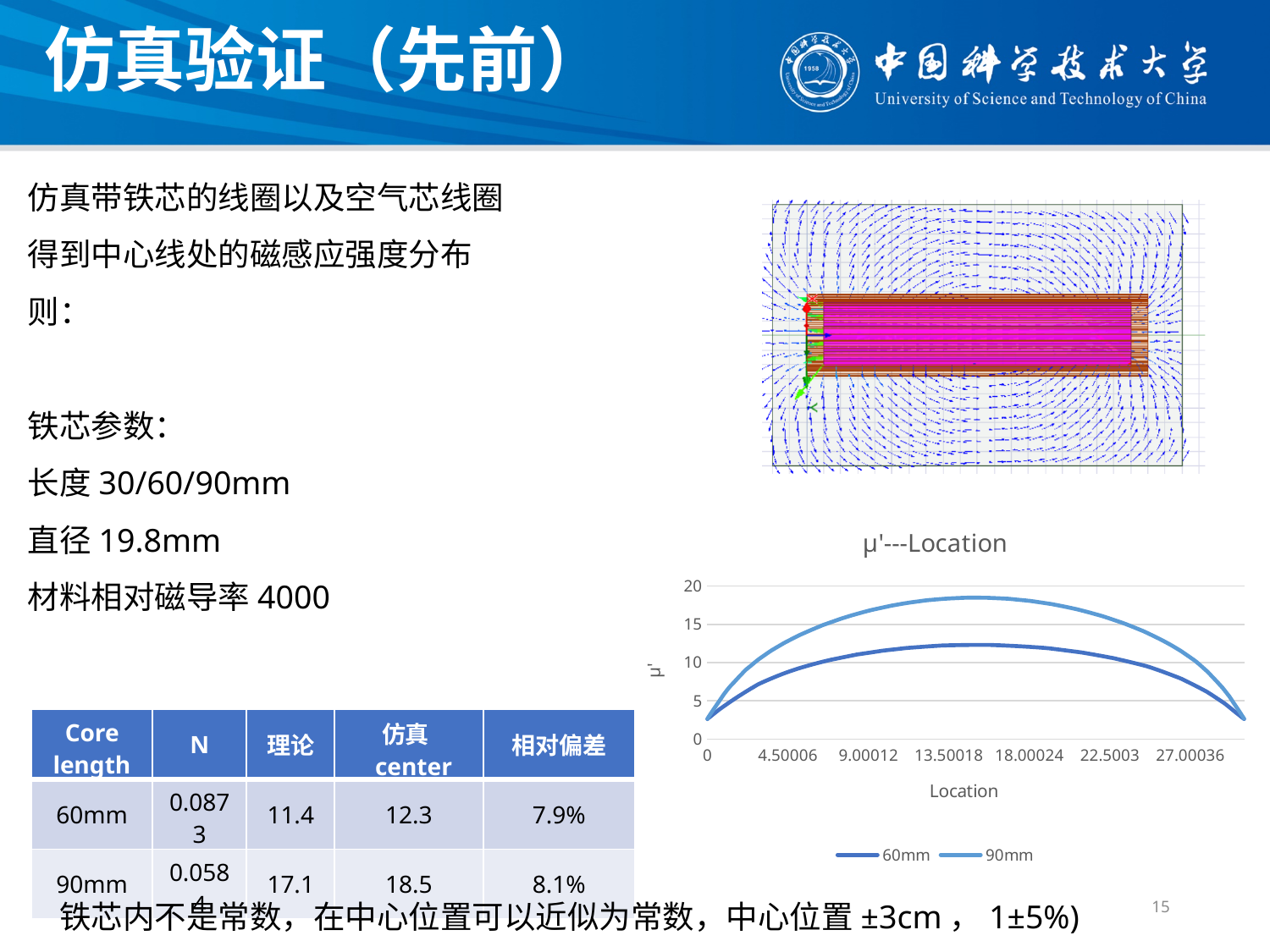
In the "μ'---Location" chart, which series has the lower value at the middle of the Location axis? 60mm How many series does the legend of the "μ'---Location" chart list? 2 In the "μ'---Location" chart, which series reaches the higher peak value, 60mm or 90mm? 90mm How many labeled tick marks are shown on the Location axis of the "μ'---Location" chart? 7 In the "μ'---Location" chart, is the peak value of the 90mm series greater or less than 20? less What kind of chart is the "μ'---Location" chart? line chart In the "μ'---Location" chart, how do the values of each series change as Location increases from 0 to the right end? They rise to a peak near the middle and then fall In the "μ'---Location" chart, is the peak value of the 90mm series greater or less than 15? greater What are the two legend entries in the "μ'---Location" chart? 60mm and 90mm In the "μ'---Location" chart, is the peak value of the 60mm series greater or less than 10? greater What is the title of the line chart on the slide? μ'---Location